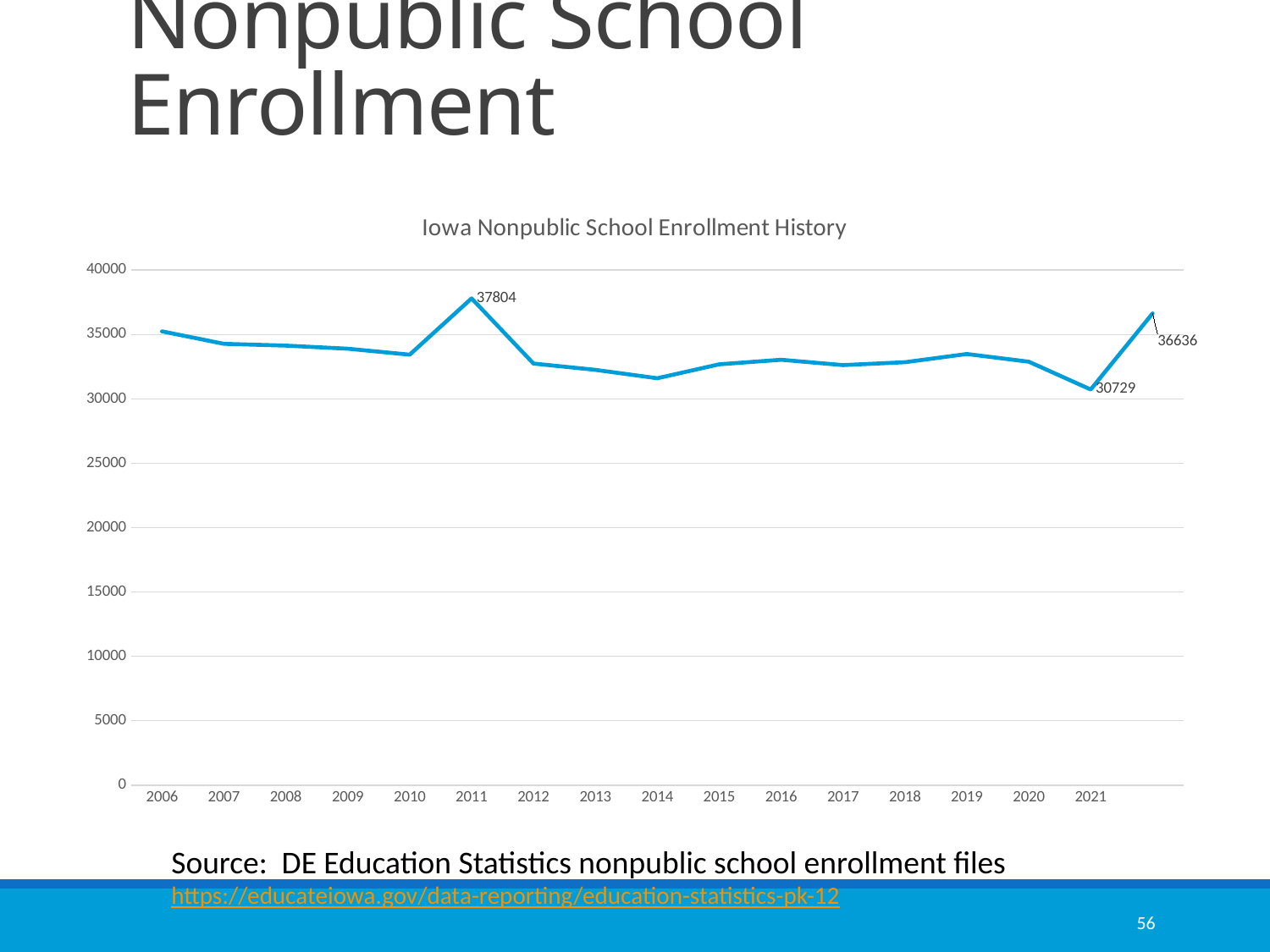
Which year has the highest enrollment on the chart? 2011 What value is shown by the data label at the right end of the line? 36636 Does enrollment rise or fall from 2011 to 2014? fall What kind of chart is shown on the slide? line chart What is the title of the chart? Iowa Nonpublic School Enrollment History What is the enrollment value labeled for 2021? 30729 Is the enrollment value for 2014 greater or less than 35000? less Is the enrollment value for 2019 greater or less than 30000? greater Which year has the lowest enrollment on the chart? 2021 Which year has the larger enrollment, 2011 or 2021? 2011 What is the enrollment value labeled for 2011? 37804 What is the difference between the labeled values for 2011 and 2021? 7075